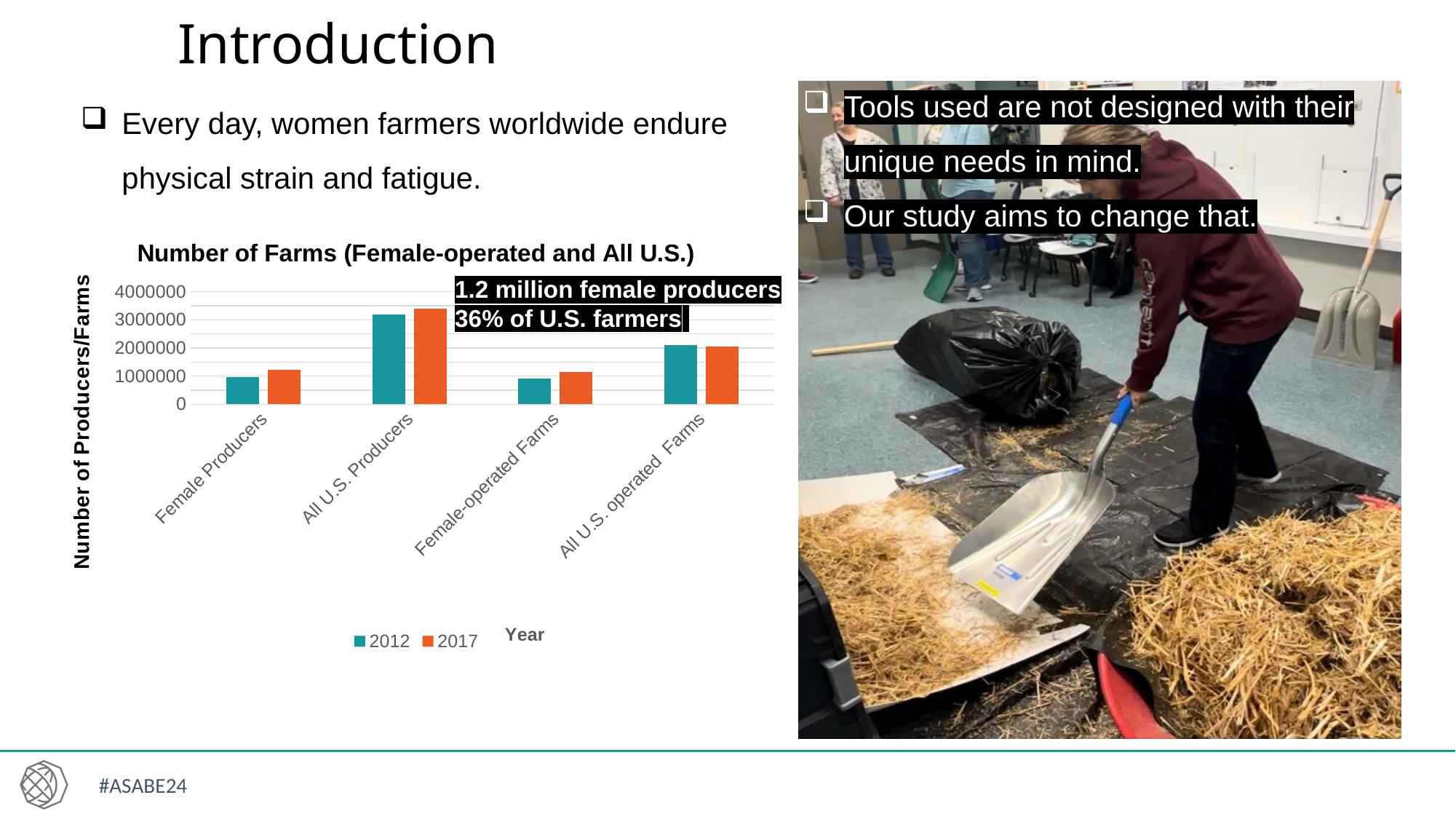
Is the 2017 value for Female Producers greater or less than 1000000? greater Which years are listed in the chart legend? 2012 and 2017 Is the 2012 value for All U.S. Producers greater or less than 3000000? greater Which category has the highest value for 2017? All U.S. Producers How many series does the chart legend list? 2 How many categories are shown on the x axis of the chart? 4 For Female Producers, which year has the larger value, 2012 or 2017? 2017 For 2012, which is larger: All U.S. Producers or All U.S. operated Farms? All U.S. Producers Which category has the highest value for 2012? All U.S. Producers What kind of chart is shown on the slide? Bar chart What is the title of the chart? Number of Farms (Female-operated and All U.S.)